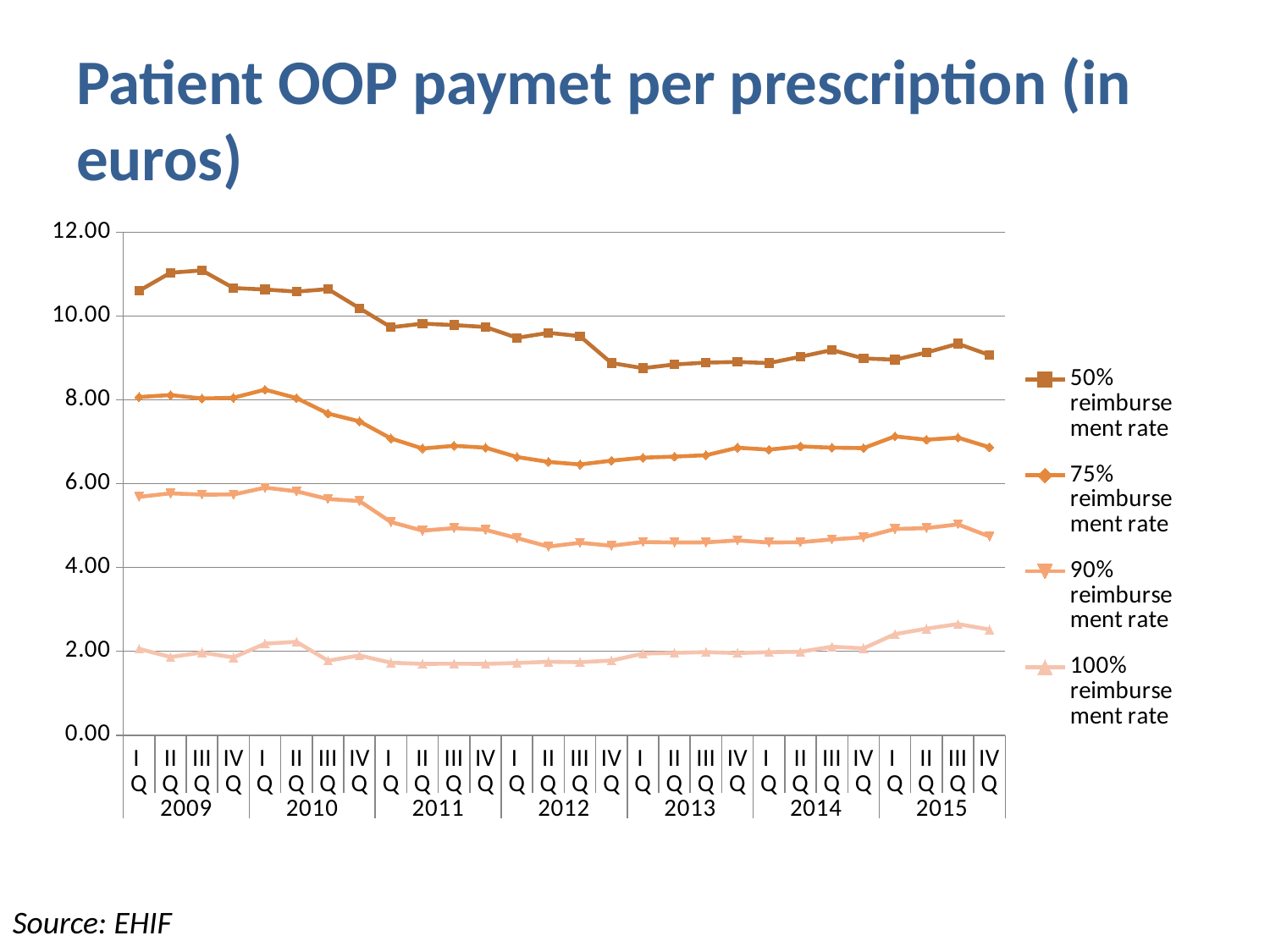
Which series has the highest values throughout the chart? 50% reimbursement rate Is the value for the 50% reimbursement rate in IV Q 2015 greater or less than 10.00? less How many years are shown on the x axis? 7 What is the title of the chart? Patient OOP paymet per prescription (in euros) How many quarterly data points are plotted for each series? 28 Is the value for the 100% reimbursement rate in III Q 2015 greater or less than 2.00? greater Does the 50% reimbursement rate series rise or fall overall from 2009 to 2015? fall What kind of chart is shown on the slide? line chart Which series has the lowest values throughout the chart? 100% reimbursement rate How many series does the legend list? 4 Is the value for the 50% reimbursement rate in I Q 2009 greater or less than 10.00? greater